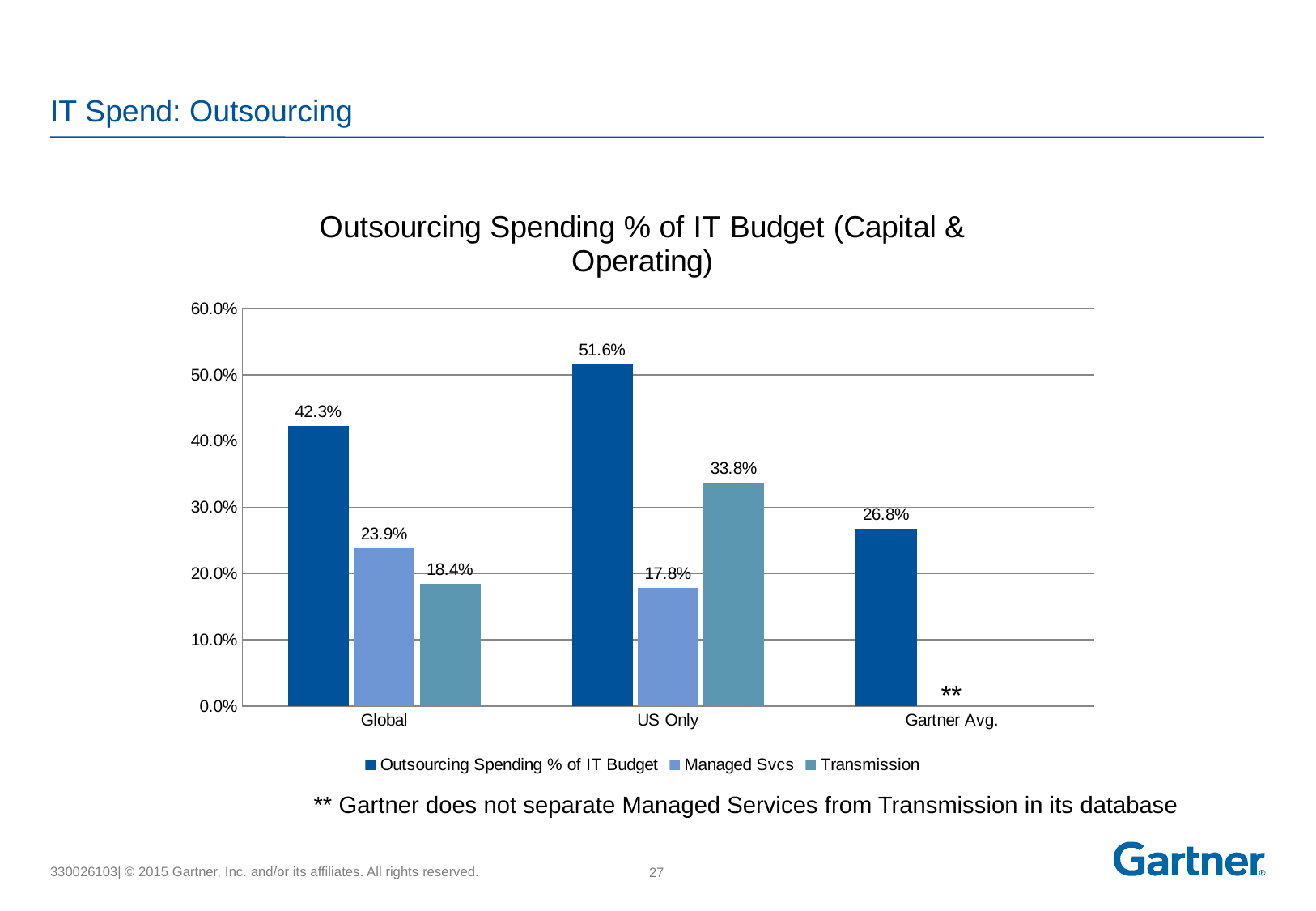
What is the Managed Svcs value for US Only? 17.8% How many categories are shown on the x axis? 3 Which category has the lowest Outsourcing Spending % of IT Budget value? Gartner Avg. What kind of chart is shown on the slide? Bar chart Which category has the highest Outsourcing Spending % of IT Budget value? US Only What is the difference between the Outsourcing Spending % of IT Budget values for US Only and Global? 9.3% Which is larger, the Transmission value for US Only or the Managed Svcs value for US Only? Transmission value for US Only What is the Outsourcing Spending % of IT Budget value for Global? 42.3% What is the Transmission value for Global? 18.4% How many series does the legend list? 3 What is the Outsourcing Spending % of IT Budget value for Gartner Avg.? 26.8% What is the title of the chart? Outsourcing Spending % of IT Budget (Capital & Operating)